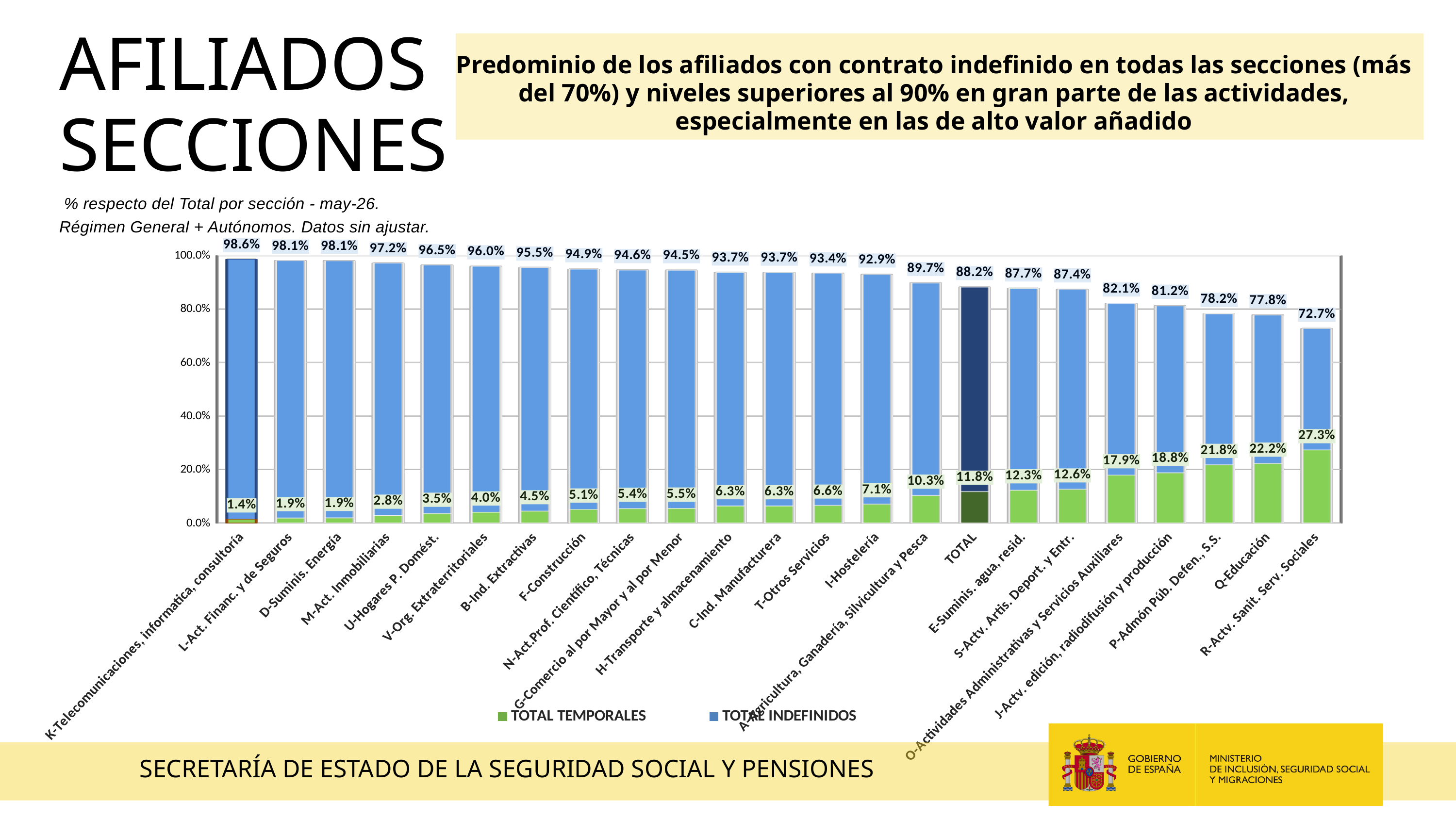
How many series does the legend list? 2 What is the TOTAL TEMPORALES value for Q-Educación? 22.2% What is the TOTAL TEMPORALES value for R-Actv. Sanit. Serv. Sociales? 27.3% Do the TOTAL INDEFINIDOS values rise or fall from left to right along the x axis? Fall What is the TOTAL INDEFINIDOS value for the TOTAL bar? 88.2% What is the difference between the TOTAL INDEFINIDOS values for I-Hostelería and A-Agricultura, Ganadería, Silvicultura y Pesca? 3.2% Which category has the highest TOTAL INDEFINIDOS value? K-Telecomunicaciones, informática, consultoría Which has a larger TOTAL TEMPORALES value, P-Admón Púb. Defen., S.S. or J-Actv. edición, radiodifusión y producción? P-Admón Púb. Defen., S.S. Which colour represents TOTAL TEMPORALES in the legend? Green What kind of chart is shown on the slide? Stacked bar chart Which category has the lowest TOTAL INDEFINIDOS value? R-Actv. Sanit. Serv. Sociales What is the TOTAL INDEFINIDOS value for K-Telecomunicaciones, informática, consultoría? 98.6%